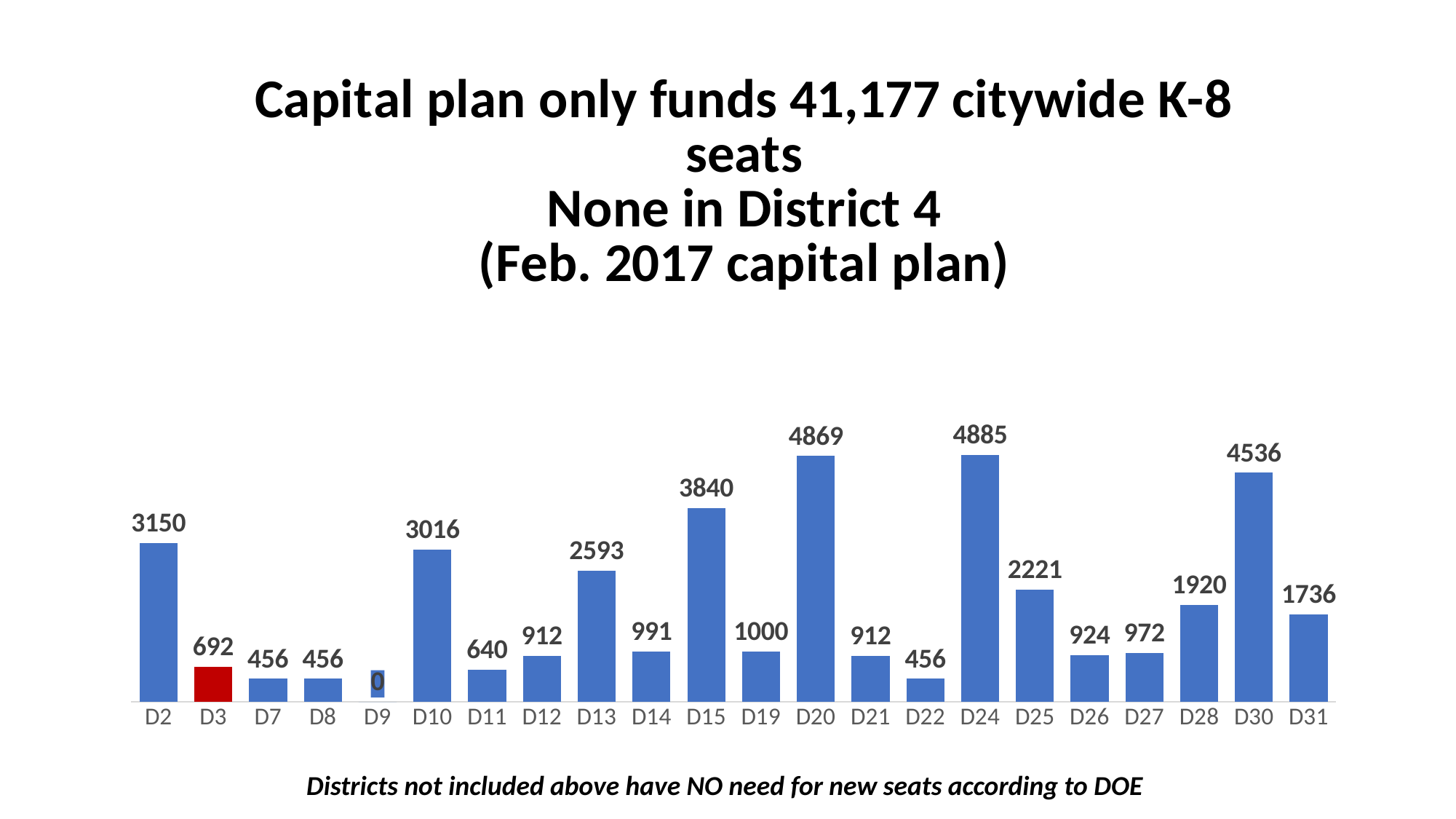
What value is shown for D25? 2221 What is the difference between the values for D30 and D31? 2800 What value is shown for D15? 3840 Which district has the highest value? D24 What value is shown for D9? 0 Which is larger, the value for D25 or the value for D28? D25 How many districts are shown on the x axis? 22 Which district has the lowest value? D9 What value is shown for D3? 692 Which district's bar is coloured red instead of blue? D3 What kind of chart is this? Bar chart What is the difference between the values for D2 and D10? 134